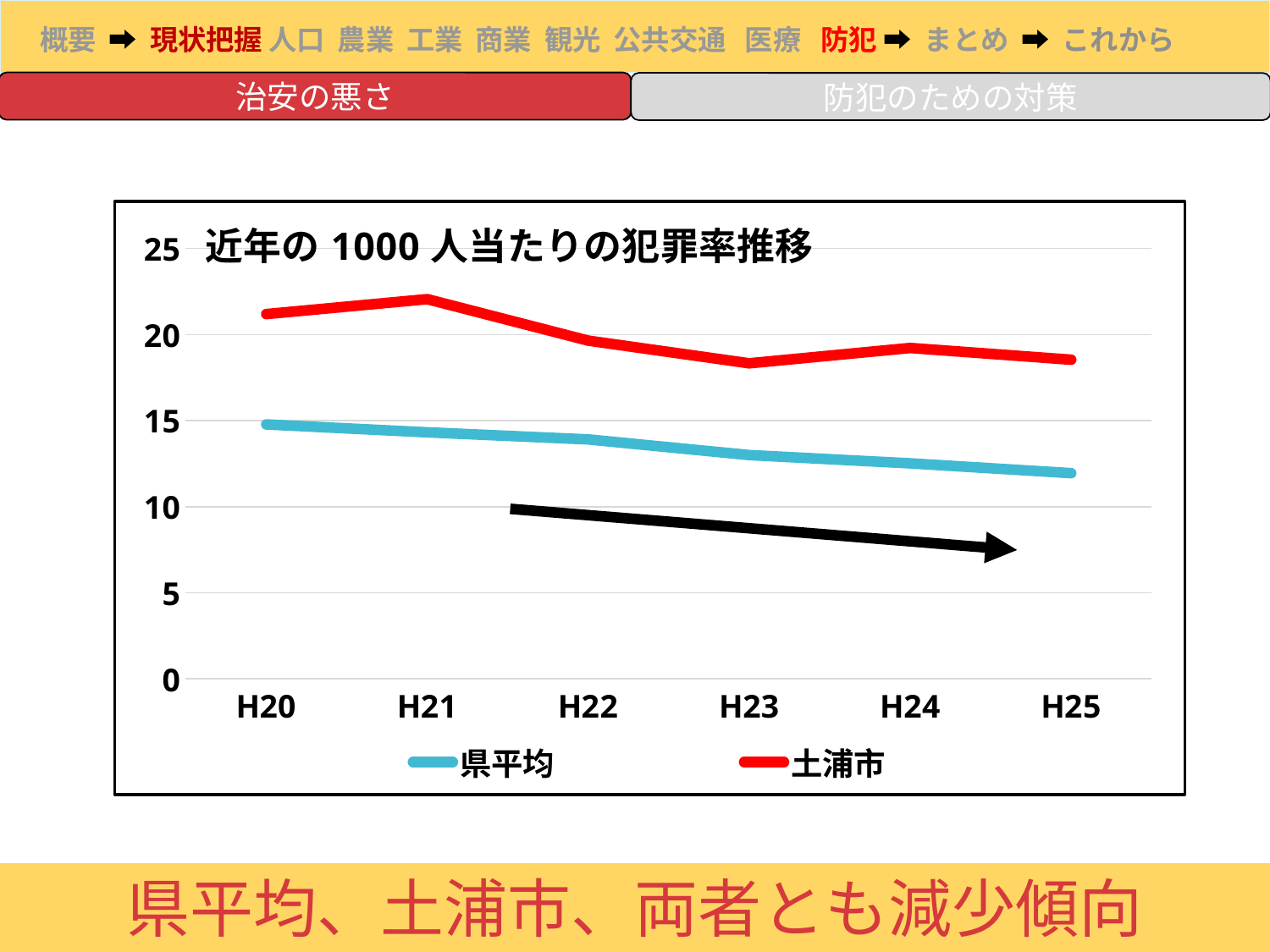
What kind of chart is shown on the slide? Line chart In which year is the value for 県平均 highest? H20 In which year is the value for 土浦市 highest? H21 Which series has the larger value in H25, 県平均 or 土浦市? 土浦市 In which year is the value for 県平均 lowest? H25 What is the title of the chart? 近年の 1000 人当たりの犯罪率推移 Is the value for 土浦市 in H21 greater or less than 20? greater How many series does the legend list? 2 How many years are plotted along the x axis? 6 Is the value for 土浦市 in H23 greater or less than 20? less Which series is drawn in red? 土浦市 Is the value for 県平均 in H25 greater or less than 10? greater